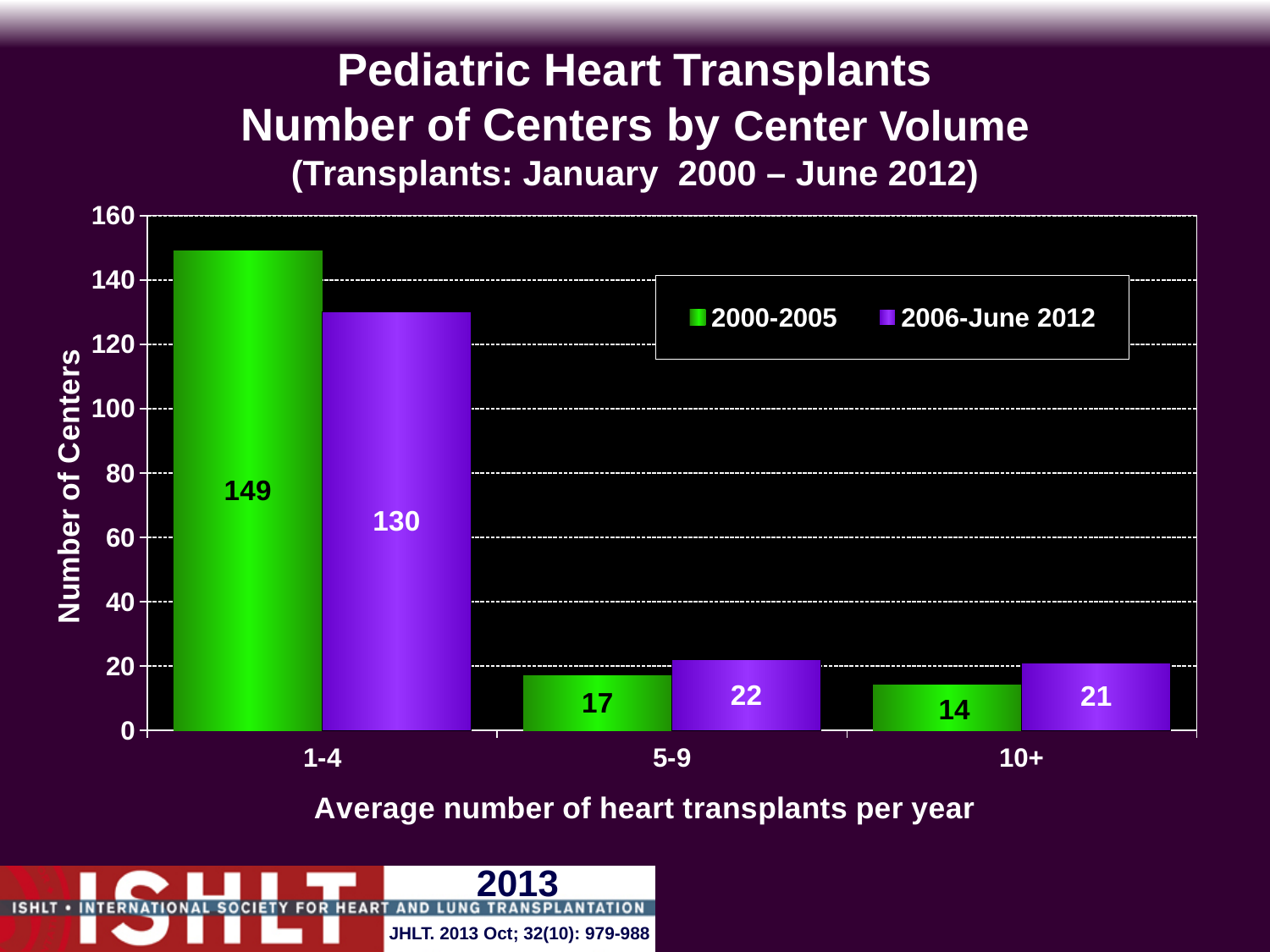
How many series does the legend list? 2 Which center volume category has the lowest number of centers for 2000-2005? 10+ What is the difference between the number of centers in the 1-4 category for 2000-2005 and for 2006-June 2012? 19 Which center volume category has the highest number of centers for 2006-June 2012? 1-4 How many centers performed 1-4 transplants per year in 2000-2005? 149 What kind of chart is shown on the slide? bar chart What is the label of the y axis? Number of Centers How many centers performed 5-9 transplants per year in 2006-June 2012? 22 How many center volume categories are shown on the x axis? 3 For the 10+ category, which period has more centers, 2000-2005 or 2006-June 2012? 2006-June 2012 Is the number of centers in the 1-4 category for 2006-June 2012 greater or less than 120? greater How many centers performed 10+ transplants per year in 2000-2005? 14